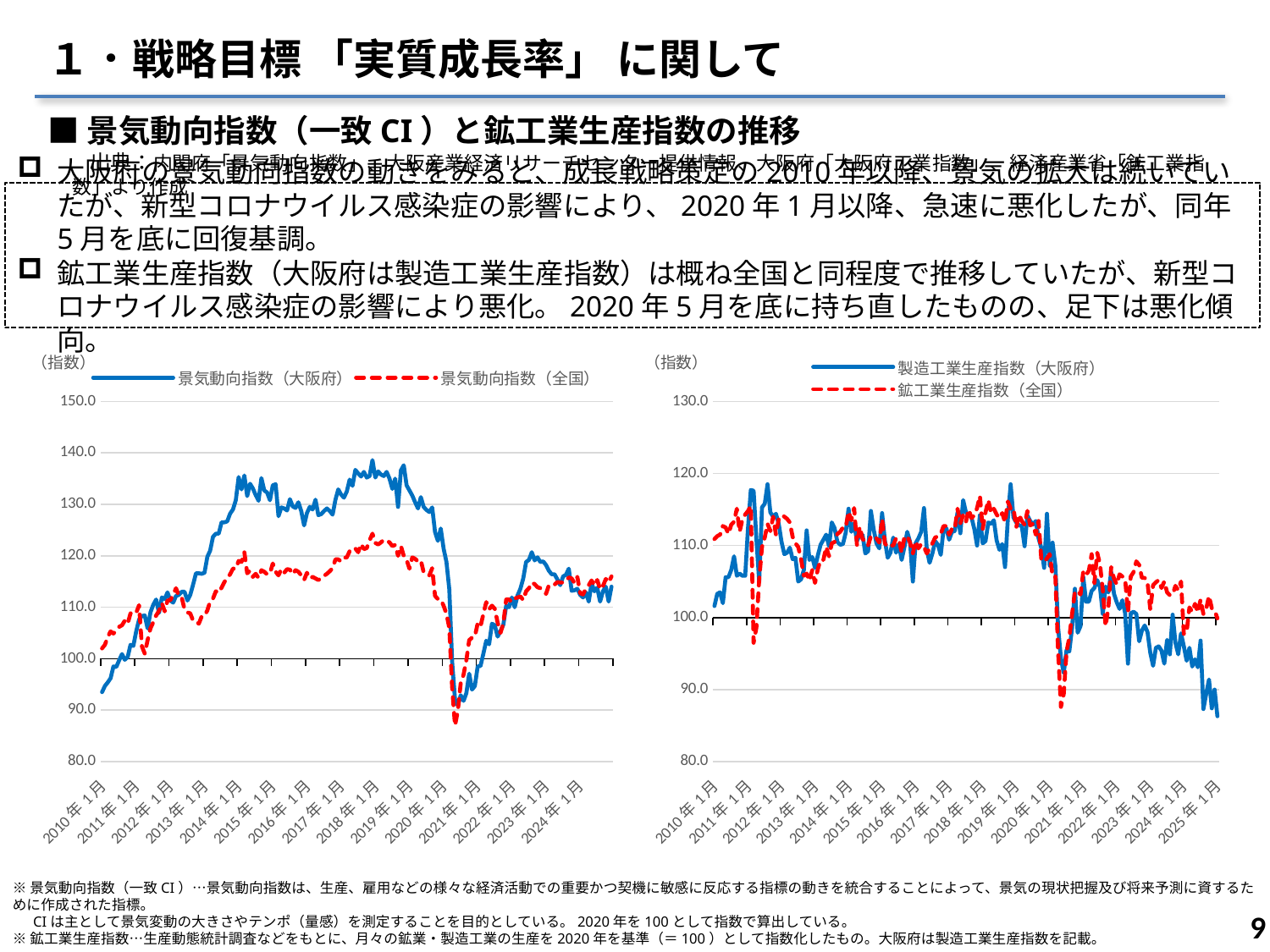
In the right chart, is the lowest value of 鉱工業生産指数（全国） around 2020年 greater or less than 100? less What kind of chart is the left chart (景気動向指数)? line chart In the left chart, is the value of 景気動向指数（大阪府） at 2010年1月 greater or less than 100? less In the right chart, which series is drawn as a red dashed line? 鉱工業生産指数（全国） In the right chart, is the value of 製造工業生産指数（大阪府） at 2025年1月 greater or less than 100? less In the left chart, does 景気動向指数（大阪府） generally rise or fall from 2010年1月 to 2018年1月? rise In the right chart, does 製造工業生産指数（大阪府） generally rise or fall from 2022年1月 to 2025年1月? fall How many series does the legend of the right chart list? 2 How many series does the legend of the left chart list? 2 What kind of chart is the right chart (製造工業生産指数・鉱工業生産指数)? line chart